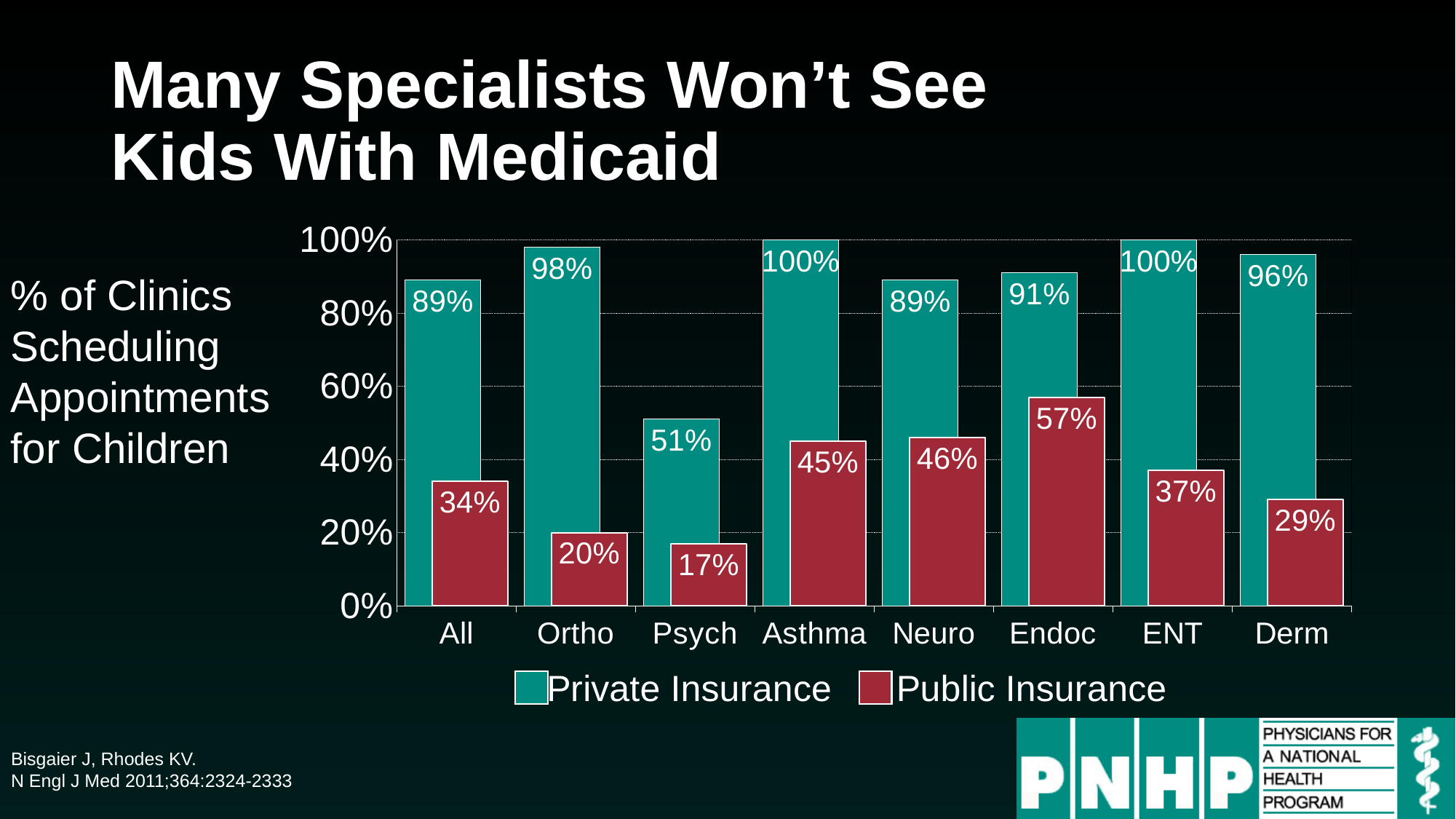
Which category has the lowest Private Insurance value? Psych Which is larger for ENT: the Private Insurance value or the Public Insurance value? Private Insurance What is the Public Insurance value for Derm? 29% What kind of chart is shown on the slide? Bar chart How many categories are shown on the x axis? 8 What is the Public Insurance value for Endoc? 57% What colour are the Public Insurance bars? Red Which category has the highest Public Insurance value? Endoc What is the difference between the Private Insurance and Public Insurance values for Ortho? 78% How many series does the legend list? 2 What is the Private Insurance value for Psych? 51% Which category has the lowest Public Insurance value? Psych